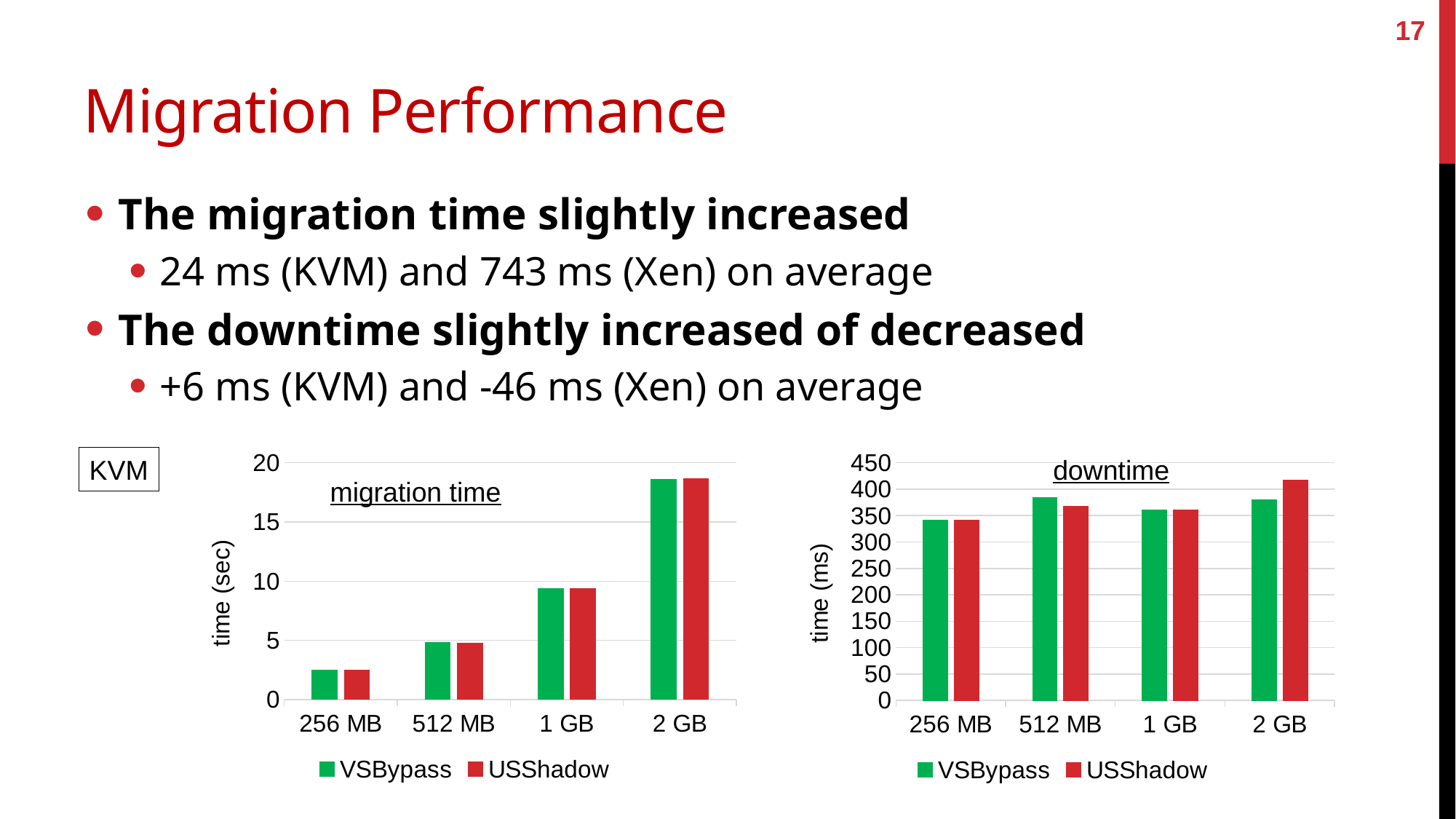
In the downtime chart, for 2 GB, which series has the larger downtime, VSBypass or USShadow? USShadow How many series does the legend of the migration time chart list? 2 In the downtime chart, which memory size has the highest USShadow downtime? 2 GB In the migration time chart, which memory size has the lowest USShadow migration time? 256 MB How many memory-size categories are shown on the x axis of the downtime chart? 4 In the downtime chart, is the USShadow value for 2 GB greater or less than 400? greater In the migration time chart, is the VSBypass value for 2 GB greater or less than 15? greater What kind of chart is the migration time chart? bar chart What is the y-axis label of the downtime chart? time (ms) In the migration time chart, do the migration times rise or fall as memory size increases along the x axis? rise In the migration time chart, which memory size has the highest VSBypass migration time? 2 GB In the migration time chart, is the USShadow value for 1 GB greater or less than 10? less